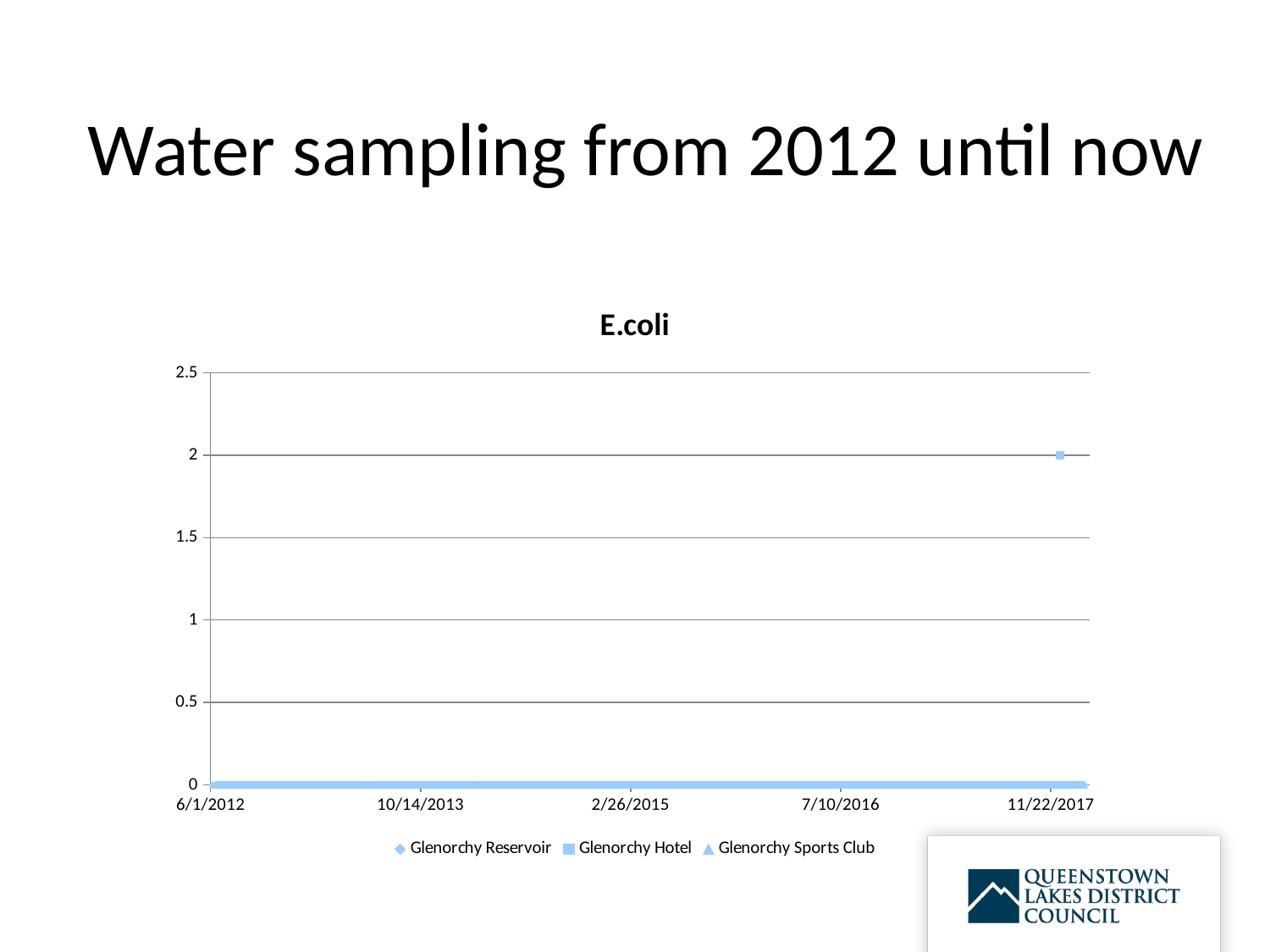
What is the title of the chart on the slide? E.coli What is the last date label on the chart's horizontal axis? 11/22/2017 At what value do nearly all of the plotted points lie along the horizontal axis? 0 What value does the single point plotted above zero reach on the vertical axis? 2 Is the value of the point plotted near 11/22/2017 greater or less than 1.5? greater What kind of chart is shown on the slide? Scatter chart What is the first date label on the chart's horizontal axis? 6/1/2012 Which series has the only point plotted above zero, near the end of 2017? Glenorchy Hotel What is the highest value shown on the chart's vertical axis? 2.5 Which series are listed in the chart's legend? Glenorchy Reservoir, Glenorchy Hotel, Glenorchy Sports Club How many series does the chart's legend list? 3 How many points on the chart are plotted above zero? 1